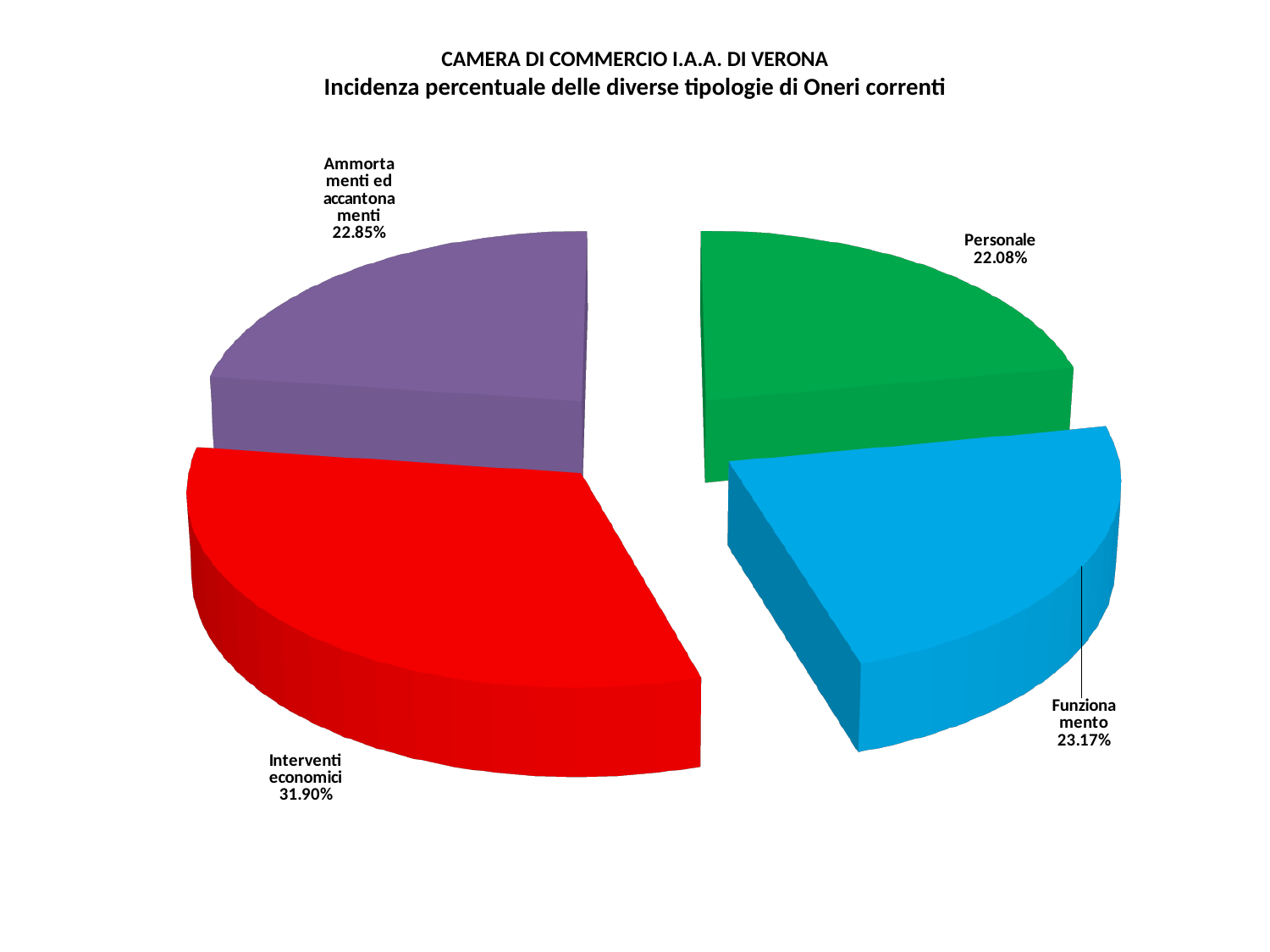
What is the share for Funzionamento? 23.17% What is the difference between the shares of Ammortamenti ed accantonamenti and Personale? 0.77% Which category has the smallest share of the pie? Personale What colour is the Interventi economici slice? red How many slices does the pie chart have? 4 Which category has the largest share of the pie? Interventi economici Which slice is larger, Funzionamento or Personale? Funzionamento What kind of chart is shown on the slide? pie chart What is the share for Ammortamenti ed accantonamenti? 22.85% What is the share for Interventi economici? 31.90% What is the share for Personale? 22.08% What is the difference between the shares of Interventi economici and Funzionamento? 8.73%